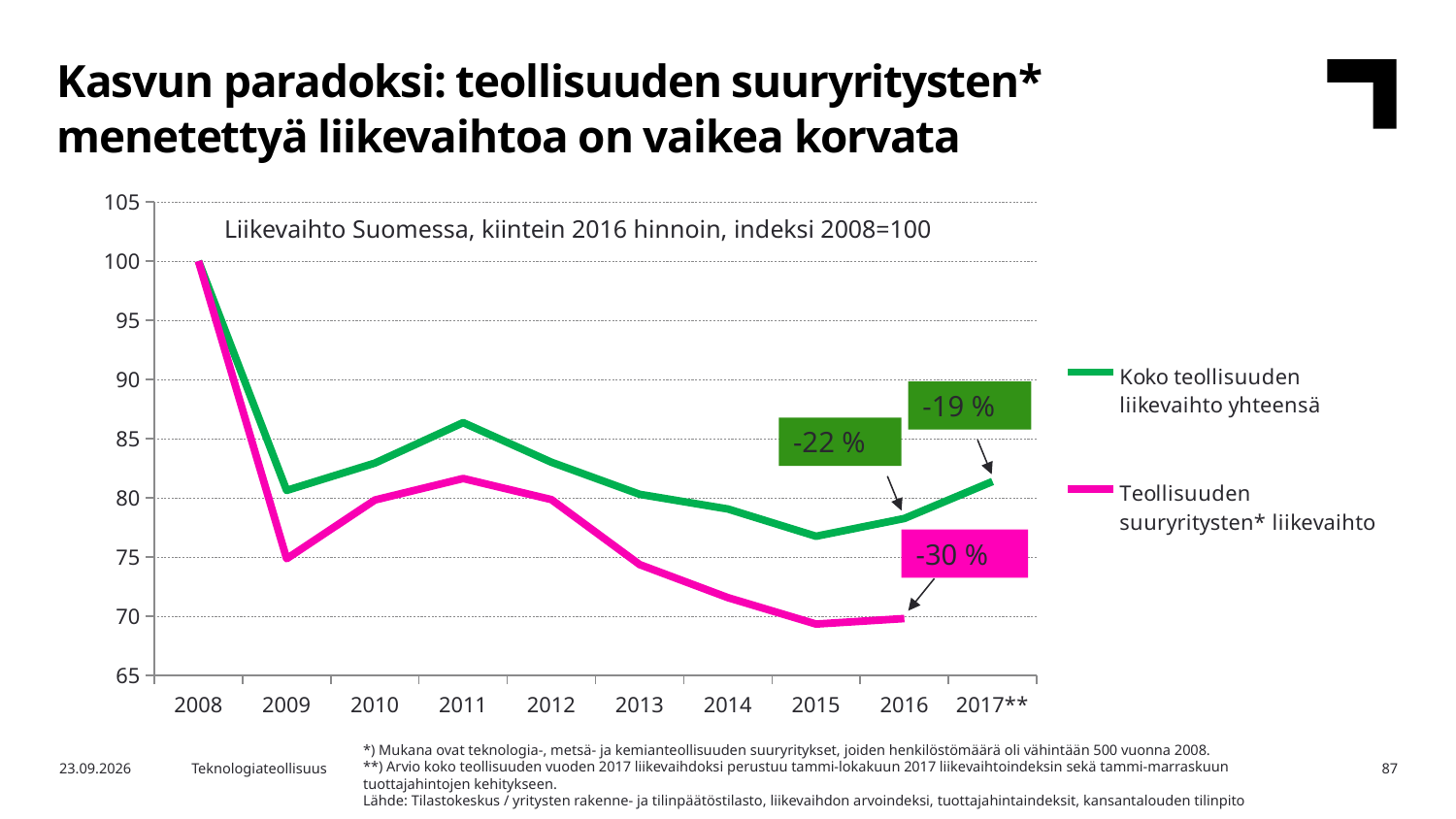
What percentage change is labelled on the Koko teollisuuden liikevaihto yhteensä line at 2016? -22 % What is the index value of both series in 2008? 100 Is the value for Teollisuuden suuryritysten* liikevaihto in 2015 greater or less than 75? less What is the title shown inside the chart area? Liikevaihto Suomessa, kiintein 2016 hinnoin, indeksi 2008=100 In 2011, which series has the higher value: Koko teollisuuden liikevaihto yhteensä or Teollisuuden suuryritysten* liikevaihto? Koko teollisuuden liikevaihto yhteensä Is the value for Koko teollisuuden liikevaihto yhteensä in 2015 greater or less than 80? less Do the values of both series rise or fall from 2008 to 2009? fall What kind of chart is shown on the slide? line chart What percentage change is labelled on the Koko teollisuuden liikevaihto yhteensä line at 2017**? -19 % How many series does the legend list? 2 How many years are shown on the x axis? 10 What percentage change is labelled on the Teollisuuden suuryritysten* liikevaihto line at 2016? -30 %